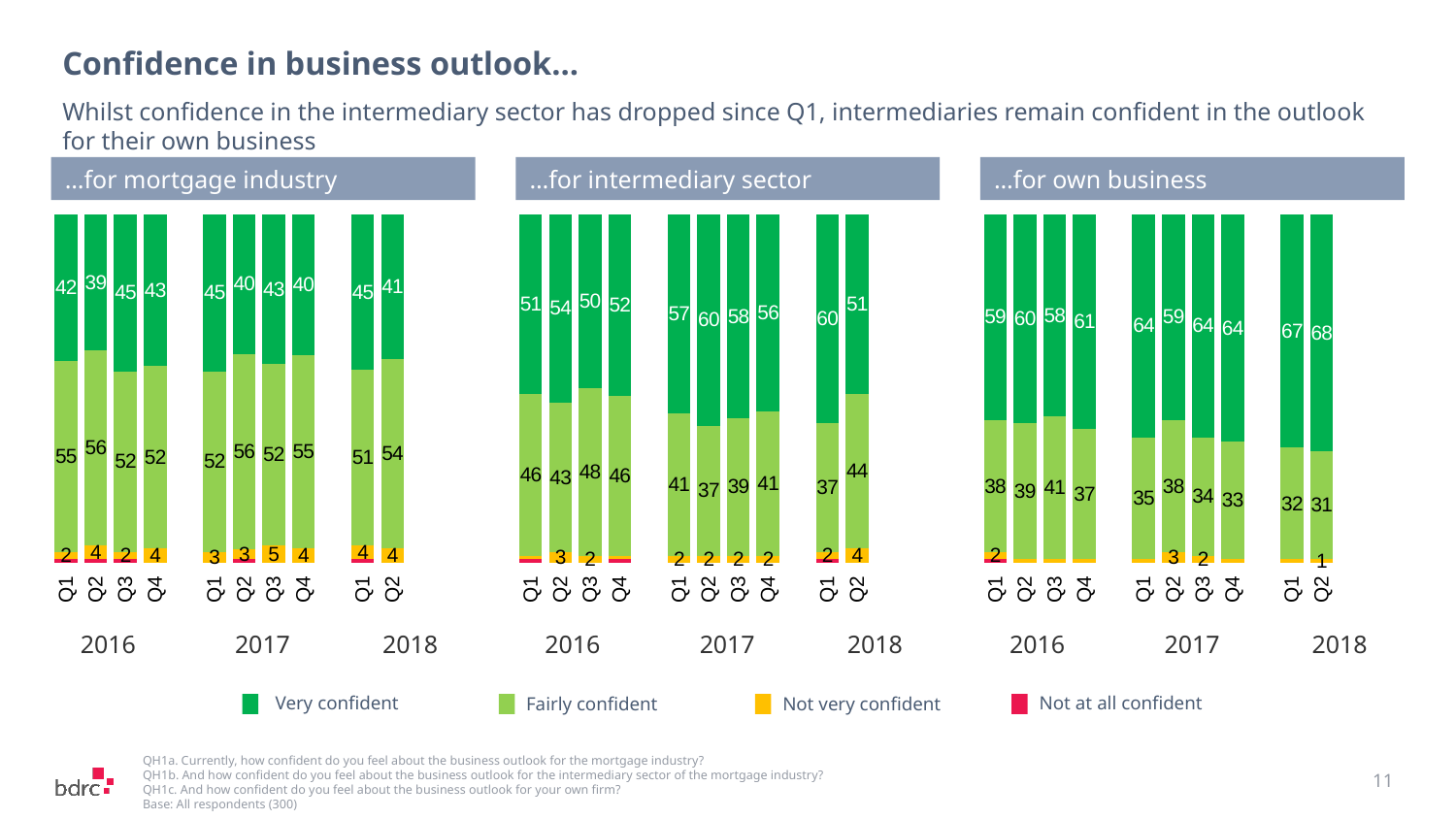
How many series does the legend list for the charts on this slide? 4 How many quarterly bars are shown in the '...for intermediary sector' chart? 10 In the '...for own business' chart, which quarter has the highest 'Very confident' value? Q2 2018 In the '...for mortgage industry' chart, what percentage of respondents were 'Very confident' in Q1 2016? 42 In the '...for mortgage industry' chart, which quarter has the lowest 'Fairly confident' value? Q1 2018 Which colour represents 'Not very confident' in the legend? Yellow What type of chart is the '...for mortgage industry' chart? Stacked bar chart In the '...for intermediary sector' chart, what is the 'Fairly confident' value for Q2 2017? 37 In the '...for intermediary sector' chart, which is larger: the 'Very confident' value for Q1 2017 or for Q2 2018? Q1 2017 In the '...for own business' chart, what is the difference between the 'Very confident' values for Q2 2018 and Q1 2016? 9 In the '...for own business' chart, what is the 'Very confident' value for Q2 2018? 68 In the '...for own business' chart, does the 'Fairly confident' value generally rise or fall from Q1 2016 to Q2 2018? fall